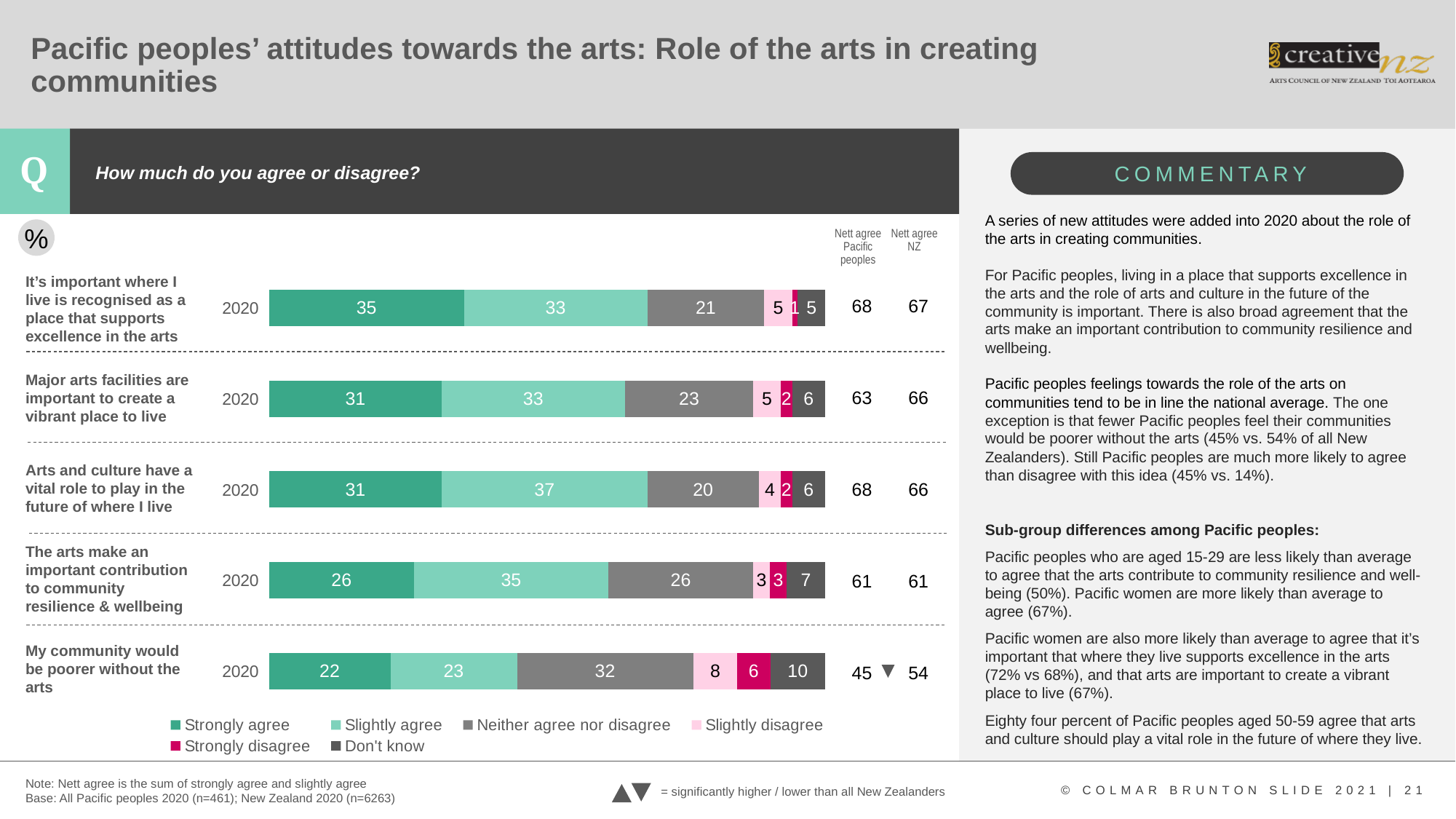
What is the Nett agree NZ value for 'Major arts facilities are important to create a vibrant place to live'? 66 What kind of chart is shown on the slide? Stacked bar chart How many series does the chart legend list? 6 What is the Neither agree nor disagree value for 'The arts make an important contribution to community resilience & wellbeing'? 26 Which has the larger Neither agree nor disagree value: 'My community would be poorer without the arts' or 'Major arts facilities are important to create a vibrant place to live'? My community would be poorer without the arts What is the Don't know value for 'My community would be poorer without the arts'? 10 How many statements are plotted in the chart? 5 Which statement has the highest Strongly agree value? It's important where I live is recognised as a place that supports excellence in the arts What is the difference between the Slightly agree values for 'Arts and culture have a vital role to play in the future of where I live' and 'Major arts facilities are important to create a vibrant place to live'? 4 Which statement has the lowest Strongly agree value? My community would be poorer without the arts What is the Strongly agree value for 'My community would be poorer without the arts'? 22 What is the Nett agree Pacific peoples value for 'My community would be poorer without the arts'? 45